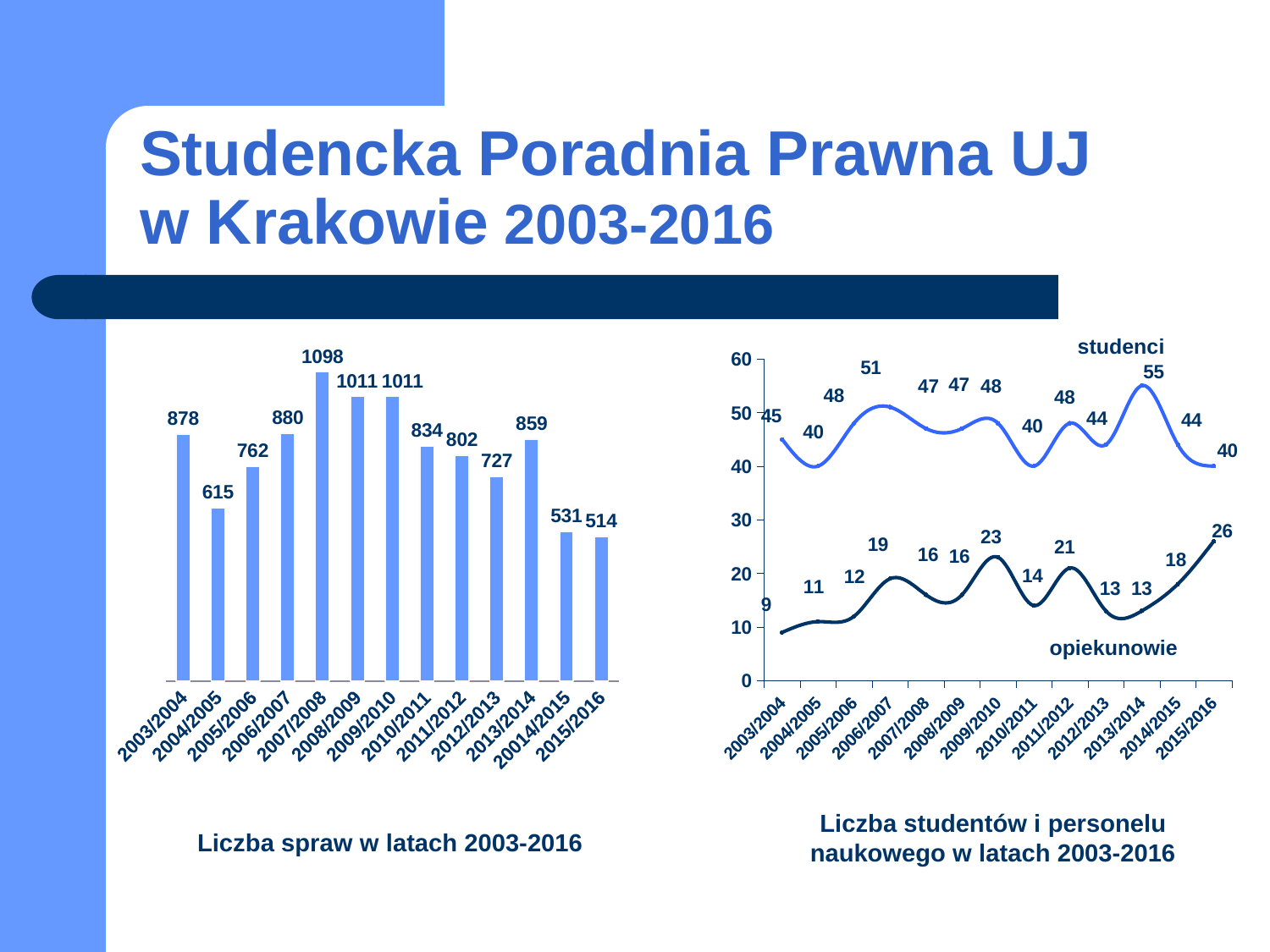
In the left chart (Liczba spraw w latach 2003-2016), what is the value for 2015/2016? 514 In the left chart (Liczba spraw w latach 2003-2016), which year has the lowest value? 2015/2016 In the right chart (Liczba studentów i personelu naukowego), which year has the lowest value for opiekunowie? 2003/2004 In the left chart (Liczba spraw w latach 2003-2016), how many bars are plotted? 13 In the right chart (Liczba studentów i personelu naukowego), what is the value for studenci in 2013/2014? 55 What kind of chart is the left chart (Liczba spraw w latach 2003-2016)? Bar chart In the right chart (Liczba studentów i personelu naukowego), what is the value for opiekunowie in 2015/2016? 26 In the left chart (Liczba spraw w latach 2003-2016), what is the value for 2007/2008? 1098 In the left chart (Liczba spraw w latach 2003-2016), what is the difference between the values for 2003/2004 and 2004/2005? 263 In the right chart (Liczba studentów i personelu naukowego), what is the difference between studenci and opiekunowie in 2003/2004? 36 In the right chart (Liczba studentów i personelu naukowego), which is larger in 2009/2010: studenci or opiekunowie? studenci What kind of chart is the right chart (Liczba studentów i personelu naukowego)? Line chart